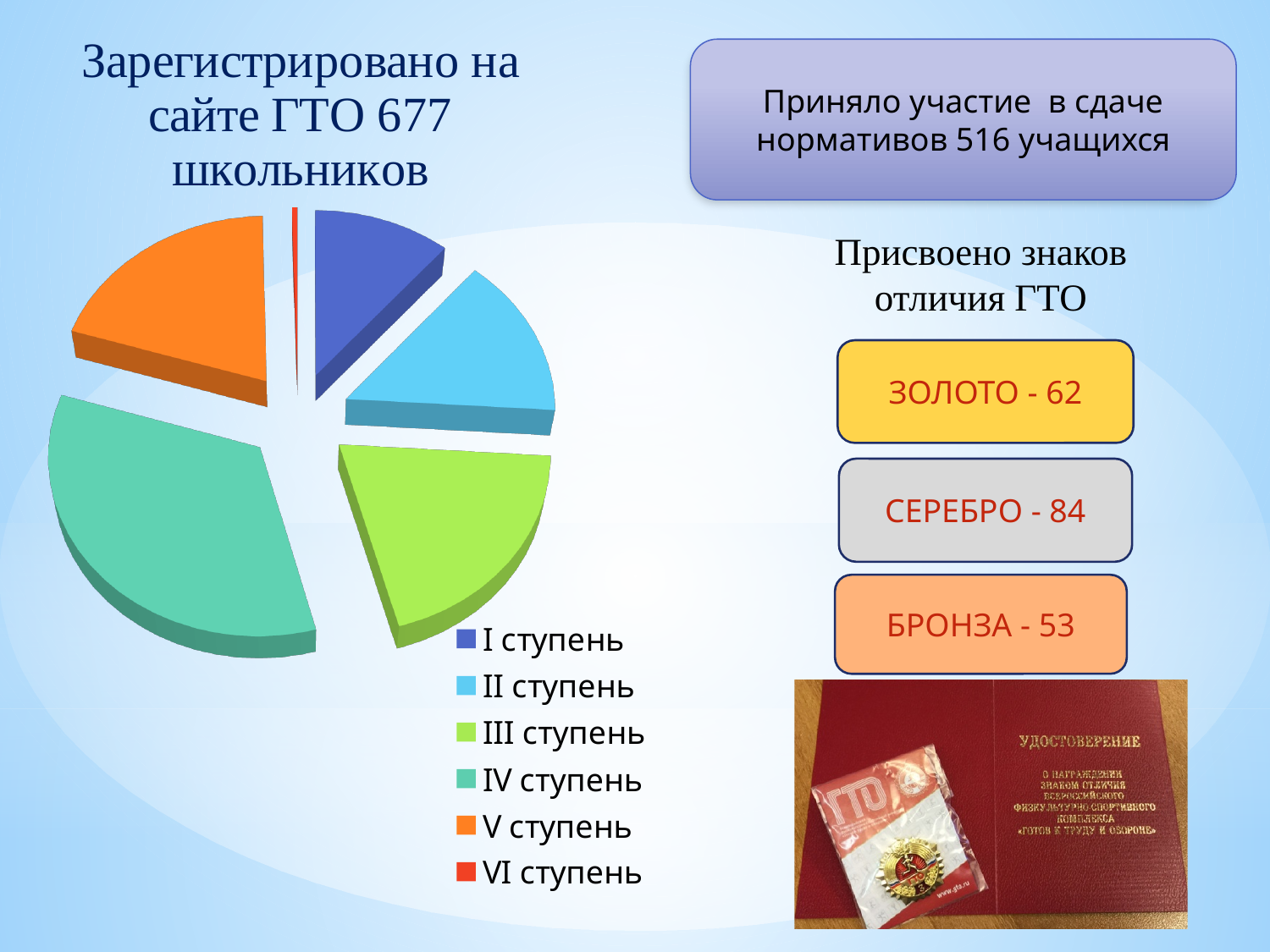
Which category has the largest slice in the pie chart? IV ступень Which category has the smallest slice in the pie chart? VI ступень What kind of chart is shown on the left of the slide? pie chart In the pie chart, which slice is larger: V ступень or I ступень? V ступень How many entries does the pie chart's legend list? 6 What colour is the IV ступень slice in the pie chart? teal (green-blue) How many slices does the pie chart have? 6 Which legend entry is shown in red in the pie chart? VI ступень In the pie chart, which slice is larger: IV ступень or I ступень? IV ступень In the pie chart, which slice is larger: III ступень or VI ступень? III ступень